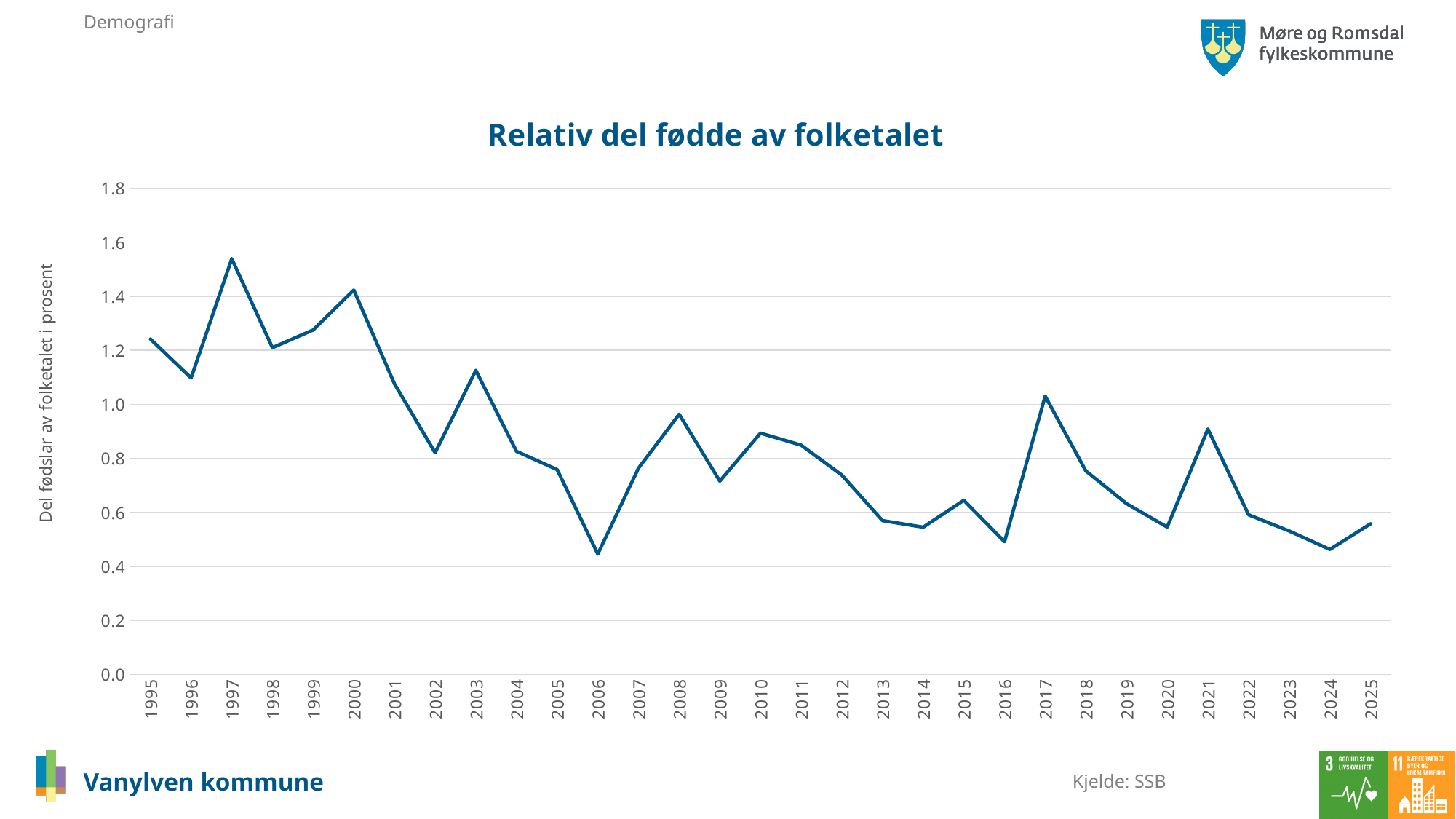
How many years are plotted along the x axis of the chart? 31 What is the title of the chart? Relativ del fødde av folketalet Which year has the highest value in the chart? 1997 What is the label on the vertical axis of the chart? Del fødslar av folketalet i prosent Is the value for 2000 greater or less than 1.2? greater Which year has the larger value, 1995 or 2025? 1995 Is the value for 2006 greater or less than 0.6? less Overall, do the values rise or fall from 1995 to 2025? fall Is the value for 1997 greater or less than 1.4? greater What kind of chart is shown on the slide? line chart Which year has the larger value, 1997 or 2000? 1997